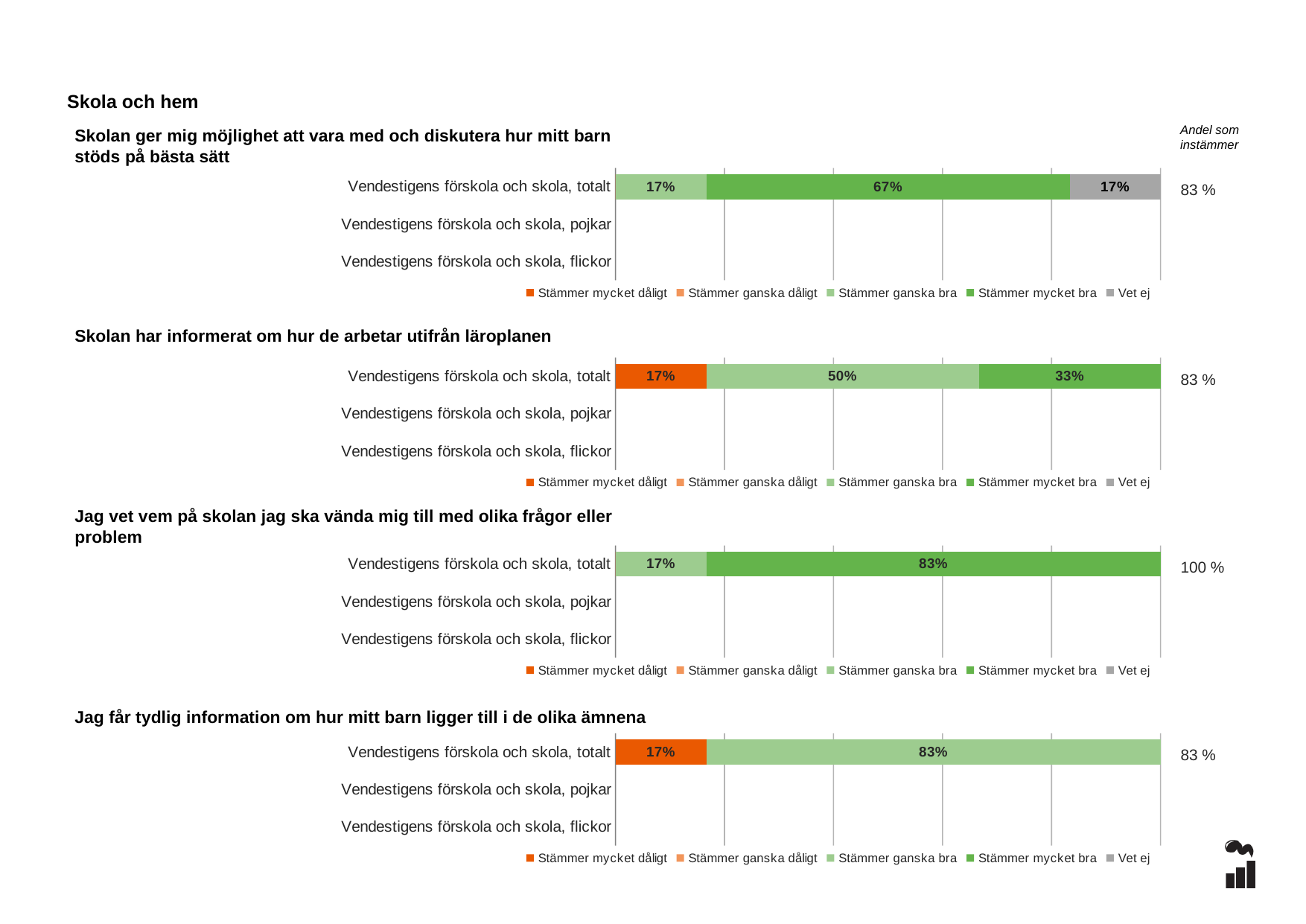
In the chart 'Skolan har informerat om hur de arbetar utifrån läroplanen', what is the value of 'Stämmer mycket dåligt' for 'Vendestigens förskola och skola, totalt'? 17% What kind of chart is 'Jag vet vem på skolan jag ska vända mig till med olika frågor eller problem'? Stacked bar chart In the chart 'Jag vet vem på skolan jag ska vända mig till med olika frågor eller problem', what is the value of 'Stämmer mycket bra' for 'Vendestigens förskola och skola, totalt'? 83% In the chart 'Skolan har informerat om hur de arbetar utifrån läroplanen', what is the value of 'Stämmer ganska bra' for 'Vendestigens förskola och skola, totalt'? 50% In the chart 'Skolan har informerat om hur de arbetar utifrån läroplanen', what is the difference between 'Stämmer ganska bra' and 'Stämmer mycket bra' for 'Vendestigens förskola och skola, totalt'? 17% In the chart 'Skolan ger mig möjlighet att vara med och diskutera hur mitt barn stöds på bästa sätt', what is the value of 'Stämmer mycket bra' for 'Vendestigens förskola och skola, totalt'? 67% In the chart 'Jag får tydlig information om hur mitt barn ligger till i de olika ämnena', what is the value of 'Stämmer ganska bra' for 'Vendestigens förskola och skola, totalt'? 83% In the chart 'Skolan ger mig möjlighet att vara med och diskutera hur mitt barn stöds på bästa sätt', what is the value of 'Vet ej' for 'Vendestigens förskola och skola, totalt'? 17% How many series does the legend list in the chart 'Jag får tydlig information om hur mitt barn ligger till i de olika ämnena'? 5 In the chart 'Skolan har informerat om hur de arbetar utifrån läroplanen', which response category has the largest share for 'Vendestigens förskola och skola, totalt'? Stämmer ganska bra In the chart 'Skolan ger mig möjlighet att vara med och diskutera hur mitt barn stöds på bästa sätt', which is larger for 'Vendestigens förskola och skola, totalt': 'Stämmer ganska bra' or 'Stämmer mycket bra'? Stämmer mycket bra What is the 'Andel som instämmer' value shown for the chart 'Jag vet vem på skolan jag ska vända mig till med olika frågor eller problem'? 100 %